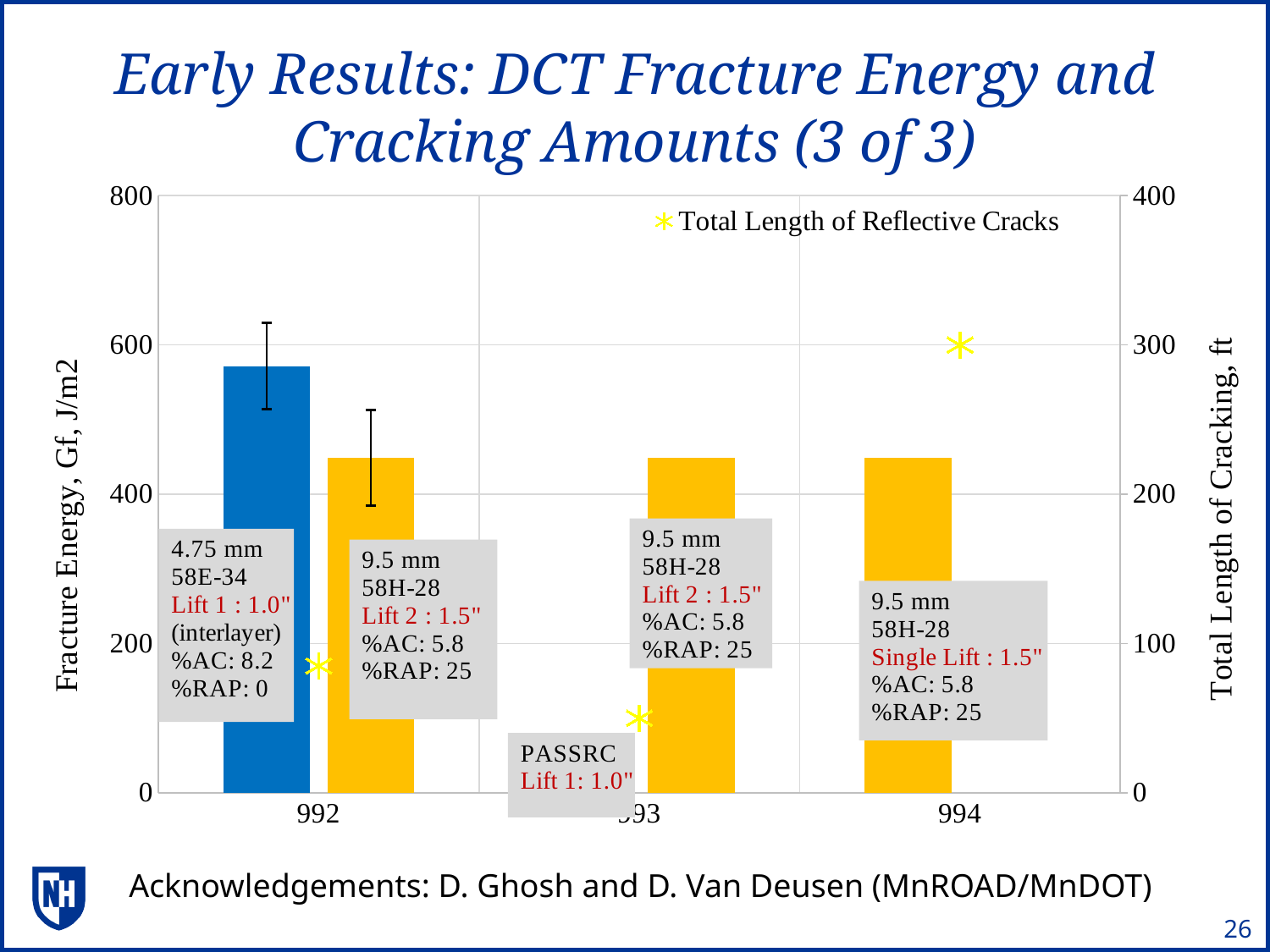
Is the fracture energy of the yellow bar in section 993 greater or less than 400 J/m2? greater Is the fracture energy of the blue bar in section 992 greater or less than 600 J/m2? less Which section has the lowest Total Length of Reflective Cracks? 993 How many series does the legend list? 1 In section 992, which bar has the higher fracture energy, the blue bar or the yellow bar? the blue bar How many test sections (categories) are shown on the x axis? 3 What is the Total Length of Reflective Cracks for section 994, in ft? 300 Which section has the highest Total Length of Reflective Cracks? 994 Is the fracture energy of the blue bar (4.75 mm 58E-34 interlayer) in section 992 greater or less than 400 J/m2? greater What is the title of the left vertical axis? Fracture Energy, Gf, J/m2 What kind of chart is shown on the slide? combination bar and line chart (bars with star markers)